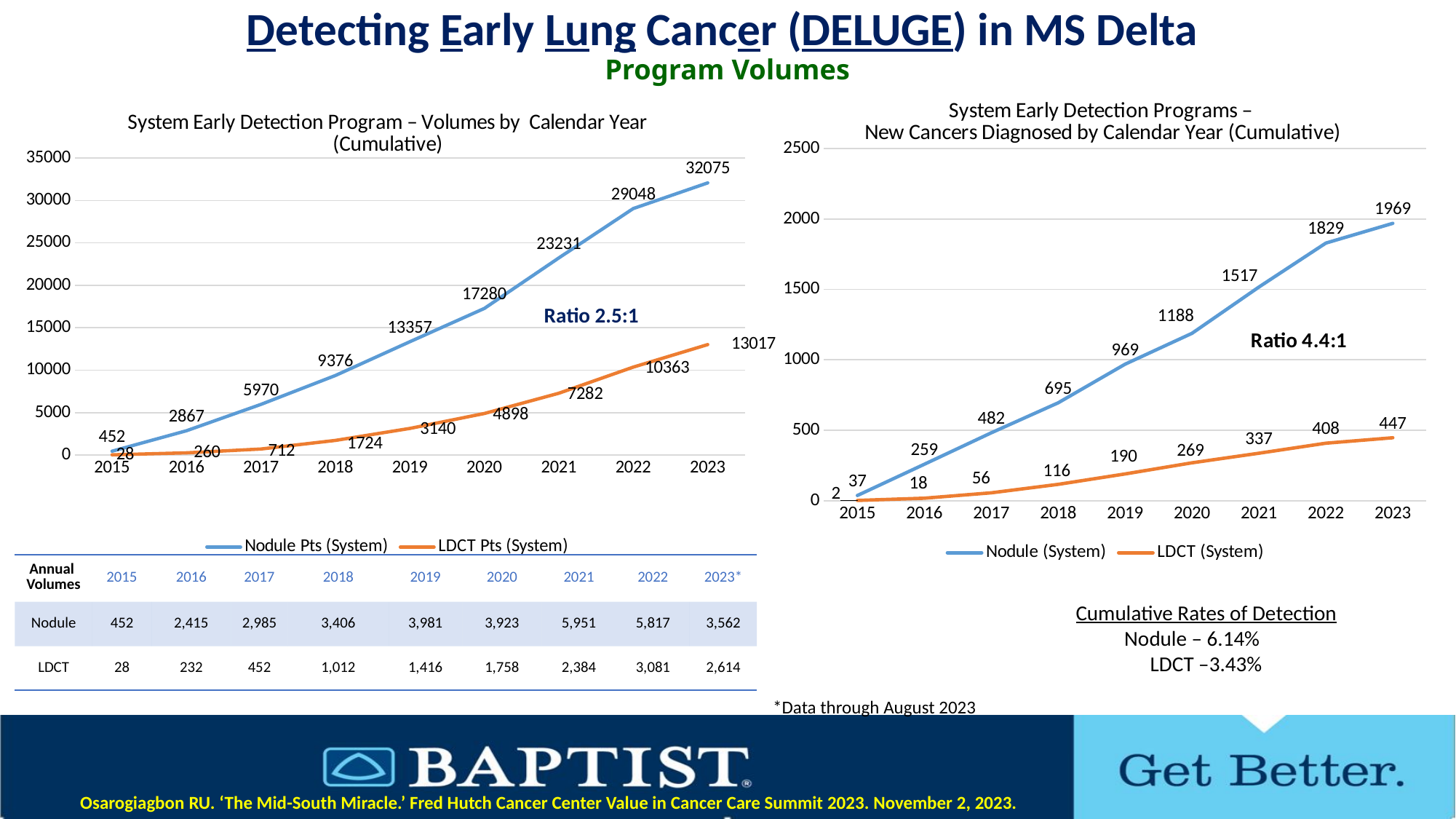
In the left chart (Volumes by Calendar Year), which year has the lowest LDCT Pts (System) value? 2015 How many years are plotted on the x axis of the left chart (Volumes by Calendar Year)? 9 In the left chart (Volumes by Calendar Year), what is the value for LDCT Pts (System) in 2019? 3140 In the right chart (New Cancers Diagnosed), what is the value for Nodule (System) in 2021? 1517 In the right chart (New Cancers Diagnosed), which series has the higher value in 2020, Nodule (System) or LDCT (System)? Nodule (System) How many series does the legend of the right chart (New Cancers Diagnosed) list? 2 In the right chart (New Cancers Diagnosed), do the Nodule (System) values rise or fall from 2015 to 2023? Rise In the left chart (Volumes by Calendar Year), what is the difference between the Nodule Pts and LDCT Pts values in 2023? 19058 In the left chart (Volumes by Calendar Year), what is the value for Nodule Pts (System) in 2023? 32075 In the right chart (New Cancers Diagnosed), what is the difference between the Nodule and LDCT values in 2022? 1421 In the right chart (New Cancers Diagnosed), what is the value for LDCT (System) in 2023? 447 What type of chart is the left chart (Volumes by Calendar Year)? Line chart